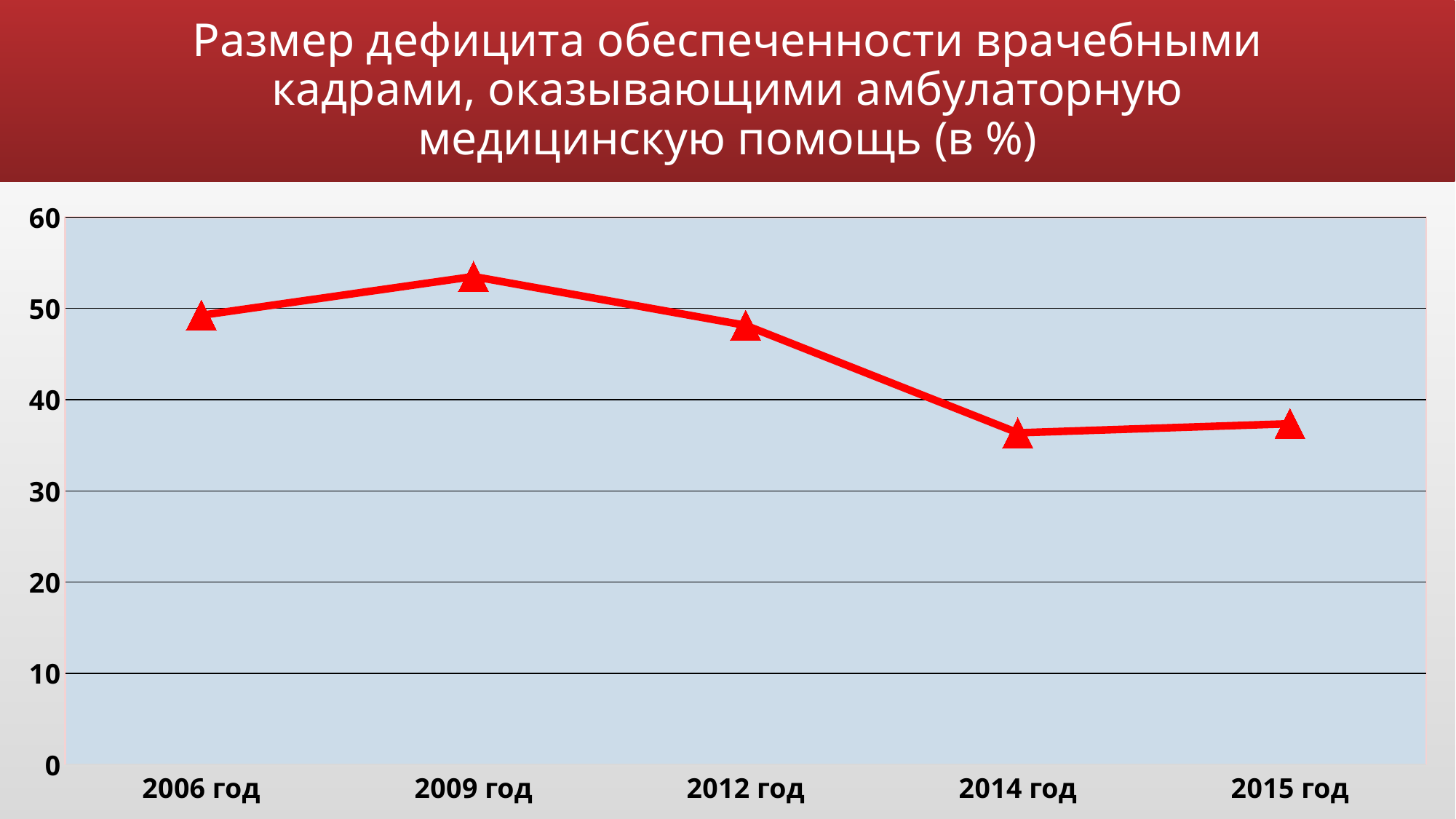
Is the value for 2006 год greater or less than 40? greater Is the value for 2014 год greater or less than 40? less Which year has the highest value on the chart? 2009 год What shape are the data point markers on the line? triangles Is the value for 2009 год greater or less than 50? greater What colour is the plotted line on the chart? red What kind of chart is shown on the slide? line chart How many years (data points) are plotted on the chart? 5 Which is larger, the value for 2009 год or the value for 2014 год? 2009 год Do the values rise or fall from 2009 год to 2014 год? fall